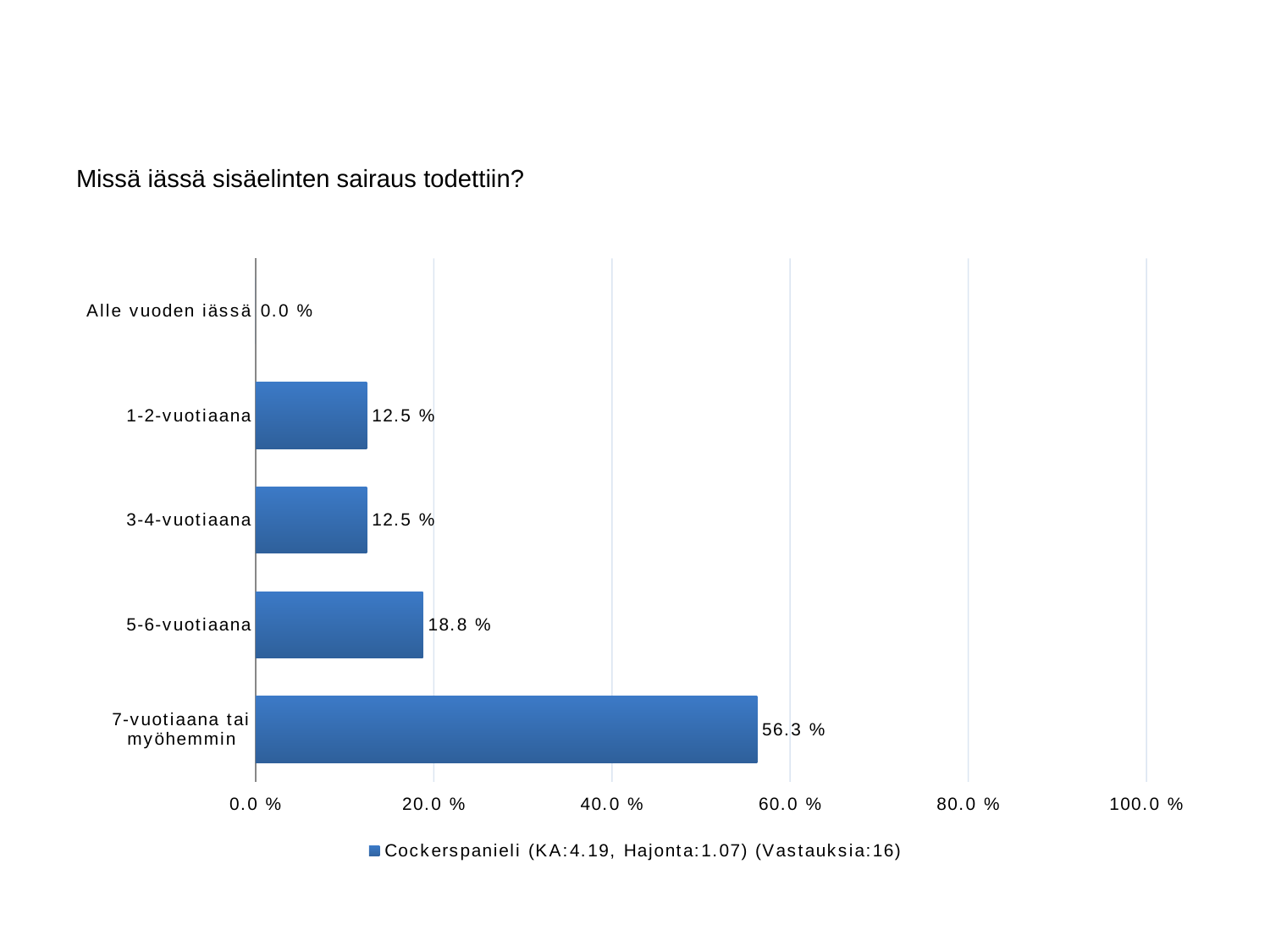
How many categories are shown in the chart? 5 What is the value for "7-vuotiaana tai myöhemmin"? 56.3 % Which is larger, the value for "5-6-vuotiaana" or the value for "3-4-vuotiaana"? 5-6-vuotiaana How many series does the legend list? 1 What kind of chart is shown on the slide? bar chart What is the value for "5-6-vuotiaana"? 18.8 % Which category has the lowest value? Alle vuoden iässä What is the title of the chart? Missä iässä sisäelinten sairaus todettiin? What is the difference between the values for "7-vuotiaana tai myöhemmin" and "5-6-vuotiaana"? 37.5 % Which category has the highest value? 7-vuotiaana tai myöhemmin What is the value for "Alle vuoden iässä"? 0.0 % Is the value for "7-vuotiaana tai myöhemmin" greater or less than 40.0 %? greater